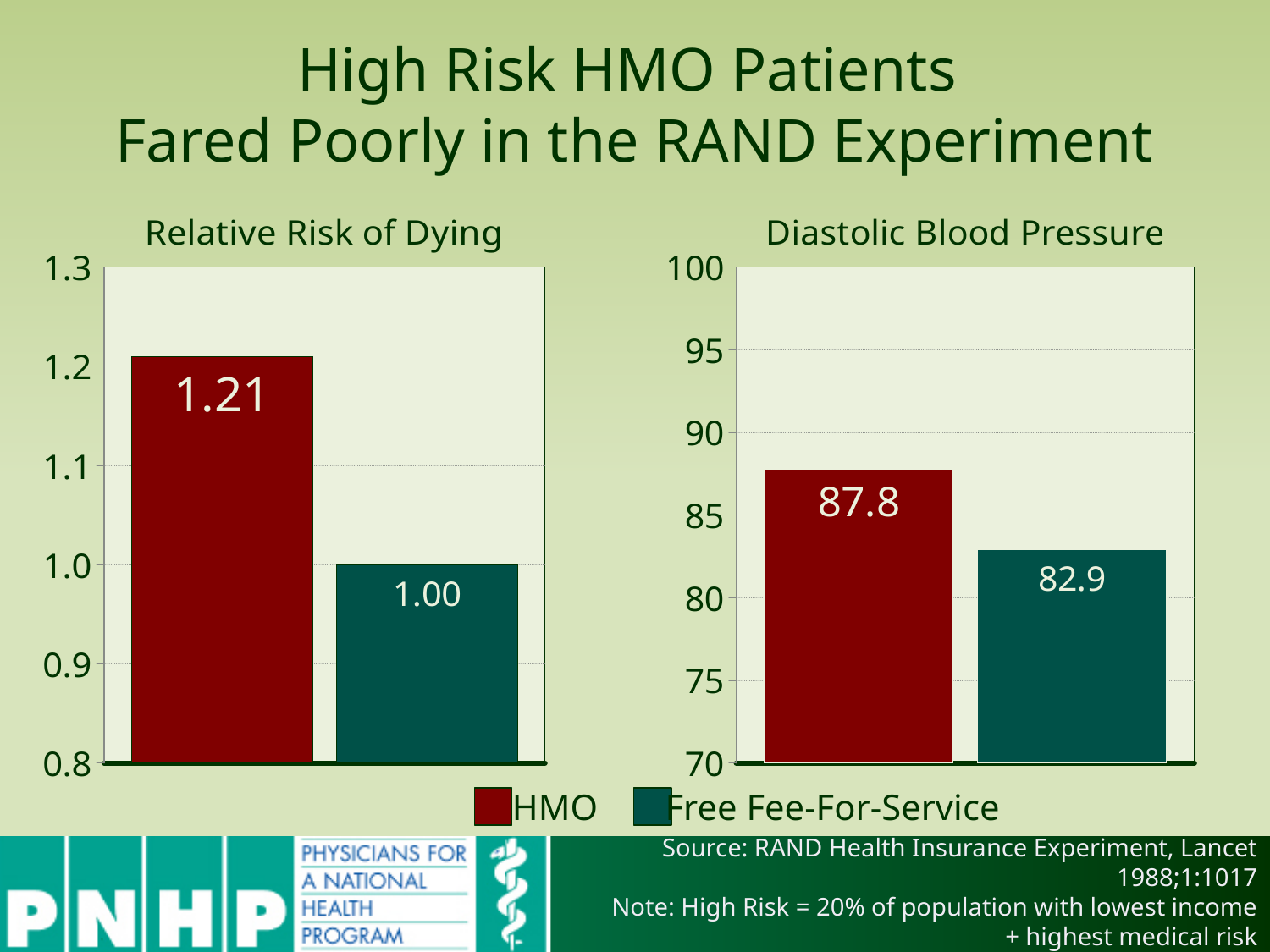
In the Relative Risk of Dying chart, is the HMO value greater or less than 1.2? greater In the Diastolic Blood Pressure chart, what is the difference between the HMO and Free Fee-For-Service values? 4.9 In the Relative Risk of Dying chart, what is the difference between the HMO and Free Fee-For-Service values? 0.21 In the Diastolic Blood Pressure chart, what is the value for Free Fee-For-Service? 82.9 What type of chart is the Diastolic Blood Pressure chart? Bar chart In the Relative Risk of Dying chart, what is the value for HMO? 1.21 How many series does the legend list? 2 In the Diastolic Blood Pressure chart, which group has the higher value? HMO In the Relative Risk of Dying chart, which group has the lower value? Free Fee-For-Service In the Relative Risk of Dying chart, what is the value for Free Fee-For-Service? 1.00 In the Diastolic Blood Pressure chart, is the Free Fee-For-Service value greater or less than 85? less In the Diastolic Blood Pressure chart, what is the value for HMO? 87.8